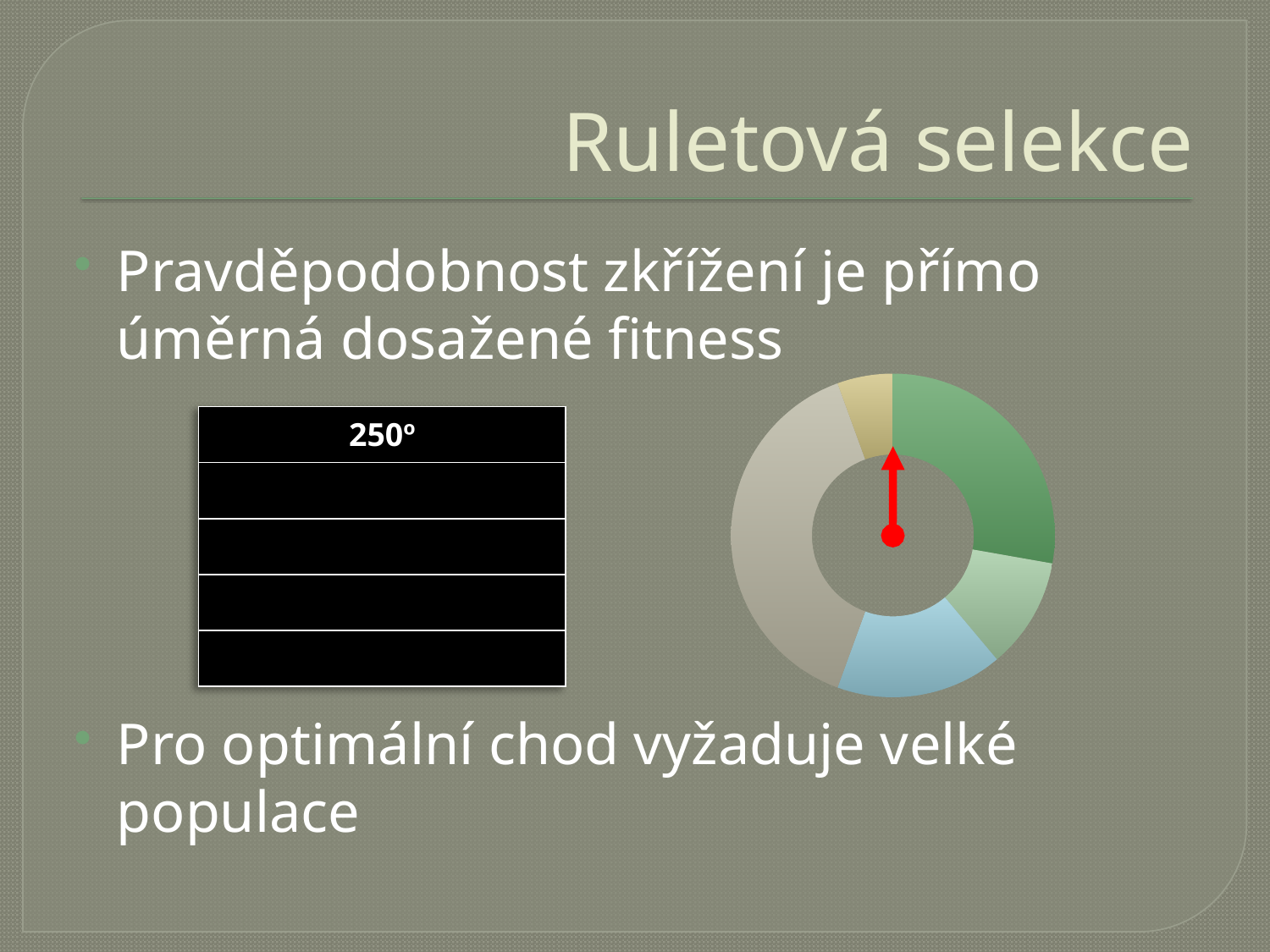
Which slice is larger in the doughnut chart, the grey slice or the dark green slice? the grey slice Does the doughnut chart show a legend? No What colour is the pointer arrow drawn in the centre of the doughnut chart? red Which slice of the doughnut chart is the largest? the grey (beige) slice How many slices does the doughnut chart have? 5 Which slice is larger in the doughnut chart, the light green slice or the light blue slice? the light blue slice Which slice is larger in the doughnut chart, the dark green slice or the light blue slice? the dark green slice Which slice of the doughnut chart is the smallest? the yellow (tan) slice What kind of chart is shown on the slide? doughnut chart